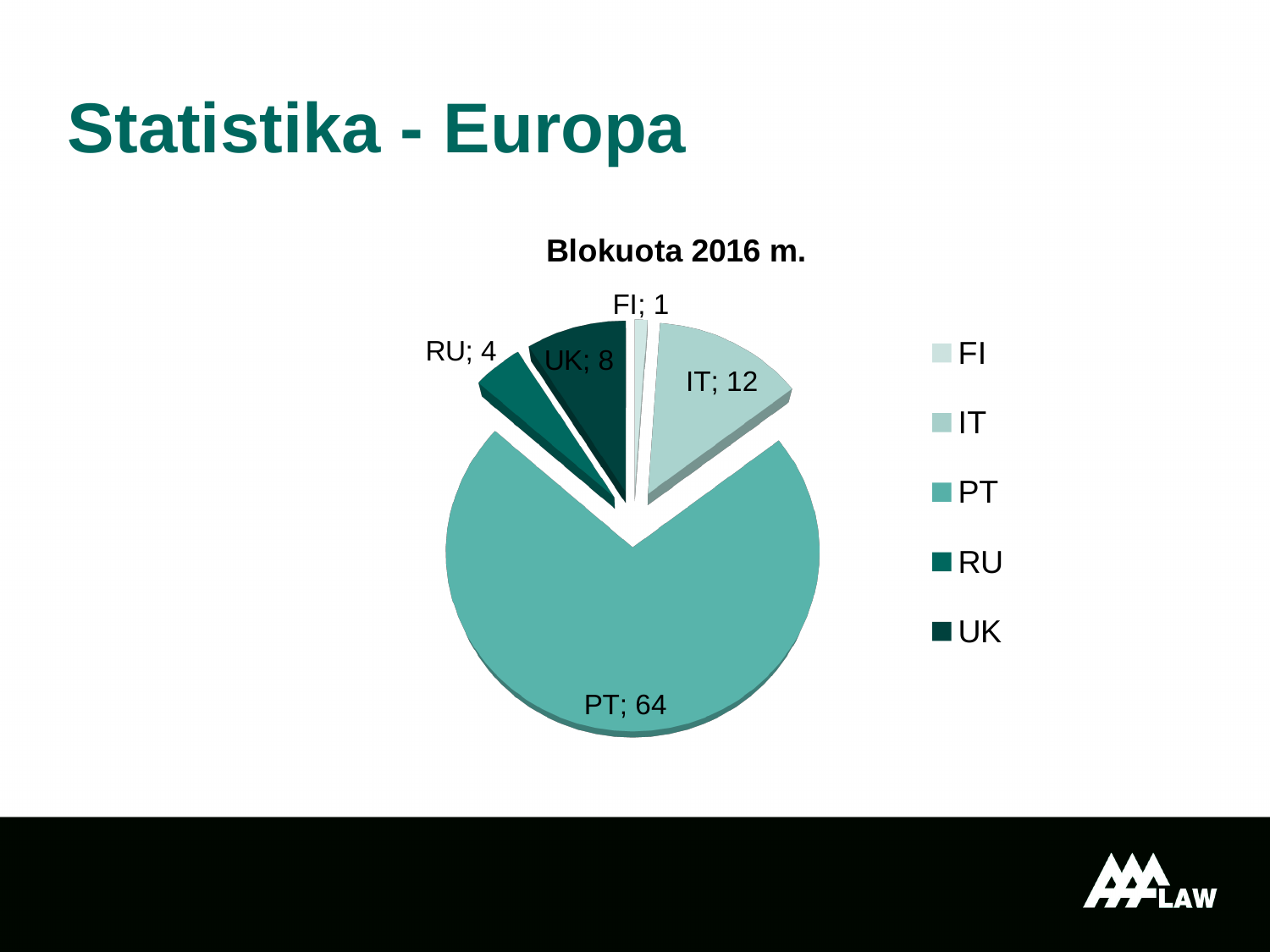
What is the title of the pie chart? Blokuota 2016 m. Which category has the largest slice in the pie chart? PT What is the value for FI in the pie chart? 1 What is the value for UK in the pie chart? 8 How many categories does the pie chart show? 5 Which is larger, the value for UK or the value for RU? UK What is the value for IT in the pie chart? 12 What is the value for RU in the pie chart? 4 What type of chart is shown on the slide? pie chart Which category has the smallest slice in the pie chart? FI What is the value for PT in the pie chart? 64 What is the difference between the values for PT and IT? 52